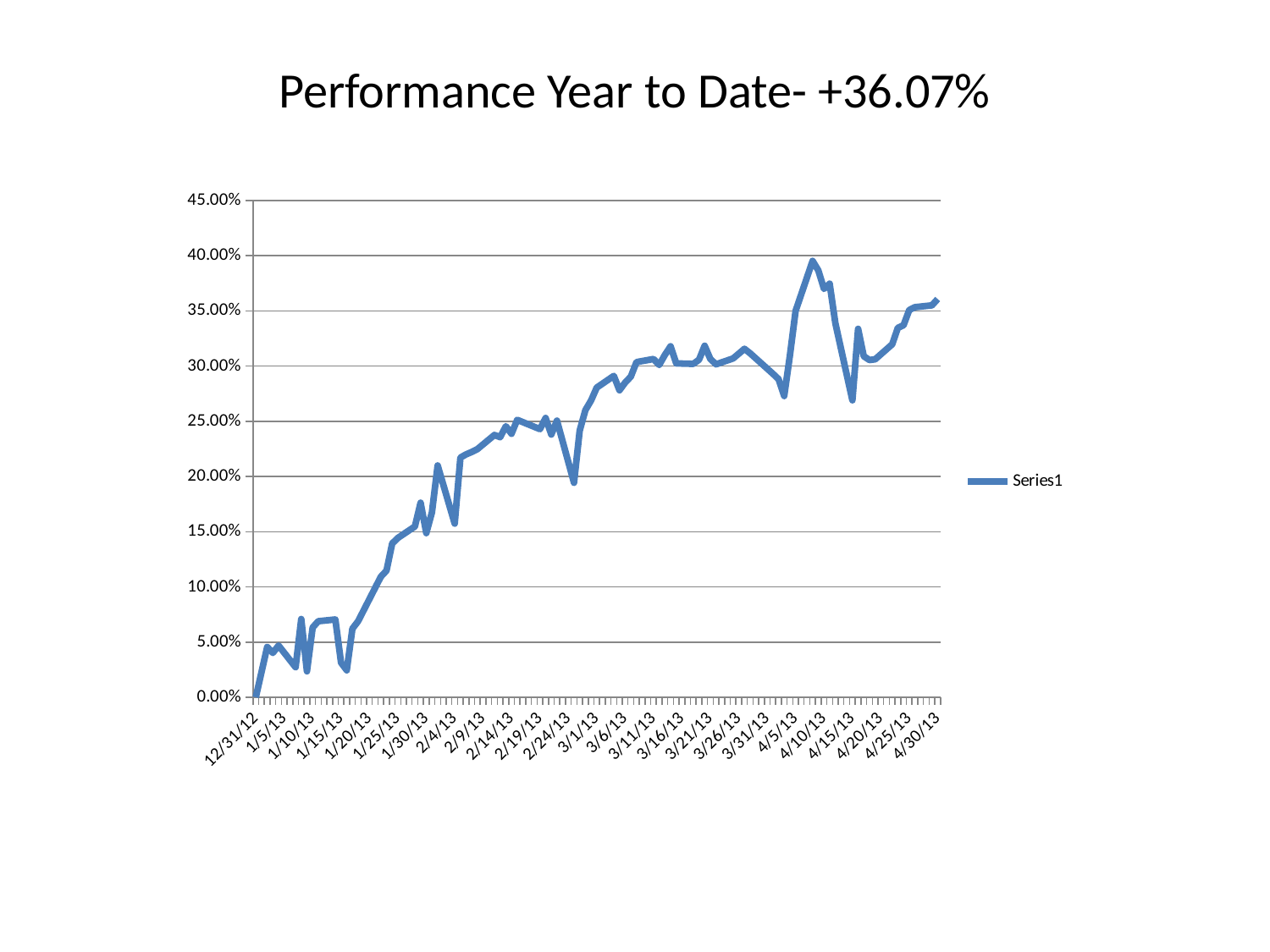
What kind of chart is shown on the slide? Line chart Is the value for 4/30/13 greater or less than 35.00%? greater What is the name of the series shown in the legend? Series1 How many series does the legend list? 1 What is the title of the chart? Performance Year to Date- +36.07% Do the values generally rise or fall from 12/31/12 to 4/30/13? rise Is the value for 1/5/13 greater or less than 10.00%? less Is the value for 3/1/13 greater or less than 25.00%? greater Which is larger, the value for 4/30/13 or the value for 1/5/13? 4/30/13 What is the value for 12/31/12? 0.00%